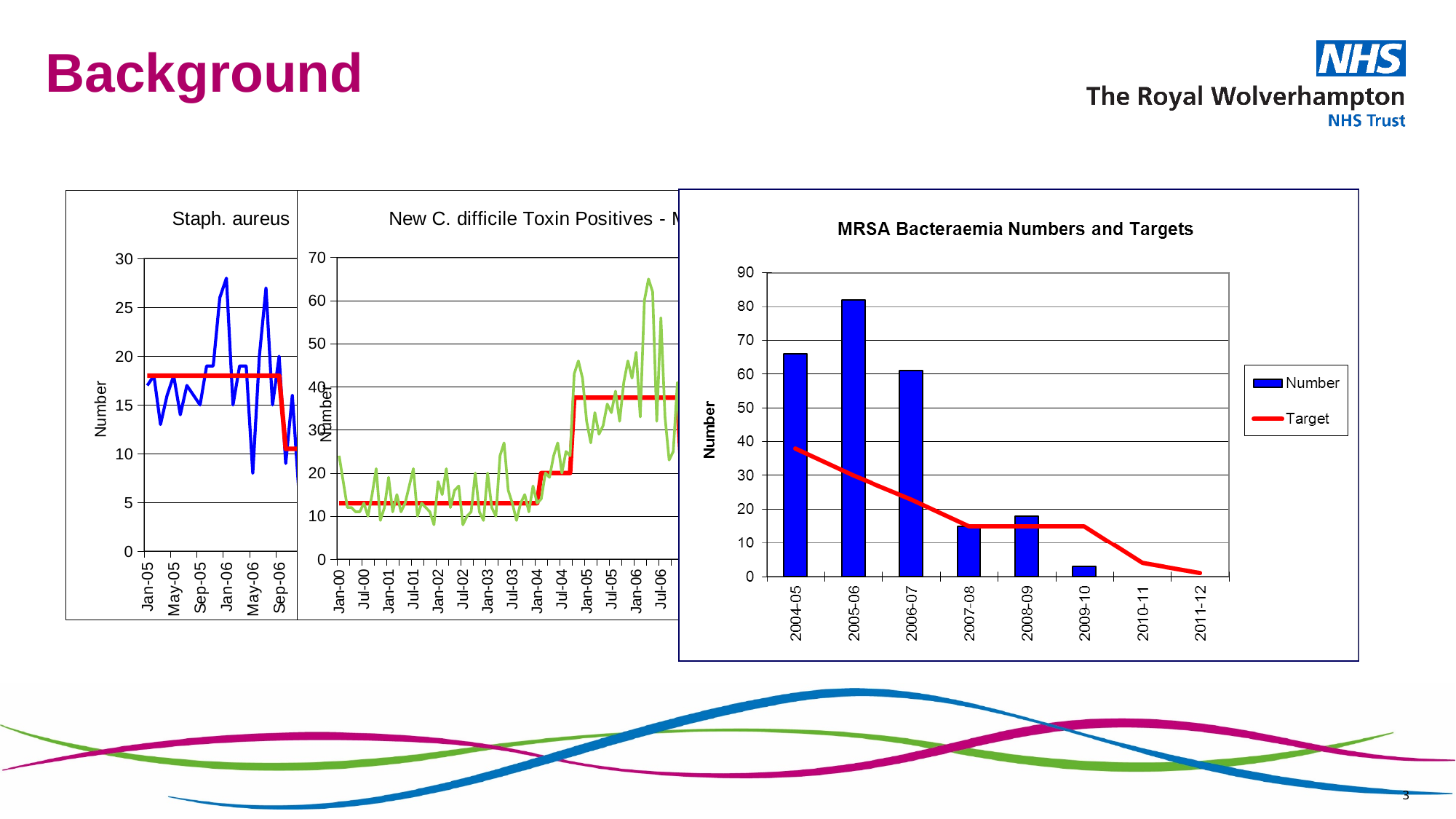
In the 'MRSA Bacteraemia Numbers and Targets' chart, what colour are the Number bars? Blue In the 'MRSA Bacteraemia Numbers and Targets' chart, which is larger, the Number for 2004-05 or for 2006-07? 2004-05 What type of chart is the 'Staph. aureus' chart on the left of the slide? Line chart In the 'MRSA Bacteraemia Numbers and Targets' chart, is the Number for 2007-08 greater or less than 20? less What type of chart is the 'MRSA Bacteraemia Numbers and Targets' chart? Bar chart with a line In the 'Staph. aureus' chart, is the highest point of the blue line greater or less than 25? greater In the 'MRSA Bacteraemia Numbers and Targets' chart, among the years with a visible bar, which has the lowest Number? 2009-10 In the 'MRSA Bacteraemia Numbers and Targets' chart, how many year categories are shown on the x axis? 8 In the 'MRSA Bacteraemia Numbers and Targets' chart, which year has the tallest Number bar? 2005-06 In the 'MRSA Bacteraemia Numbers and Targets' chart, is the Number for 2005-06 greater or less than 70? greater In the 'MRSA Bacteraemia Numbers and Targets' chart, how many series does the legend list? 2 In the 'MRSA Bacteraemia Numbers and Targets' chart, does the Target line rise or fall from 2004-05 to 2011-12? Fall